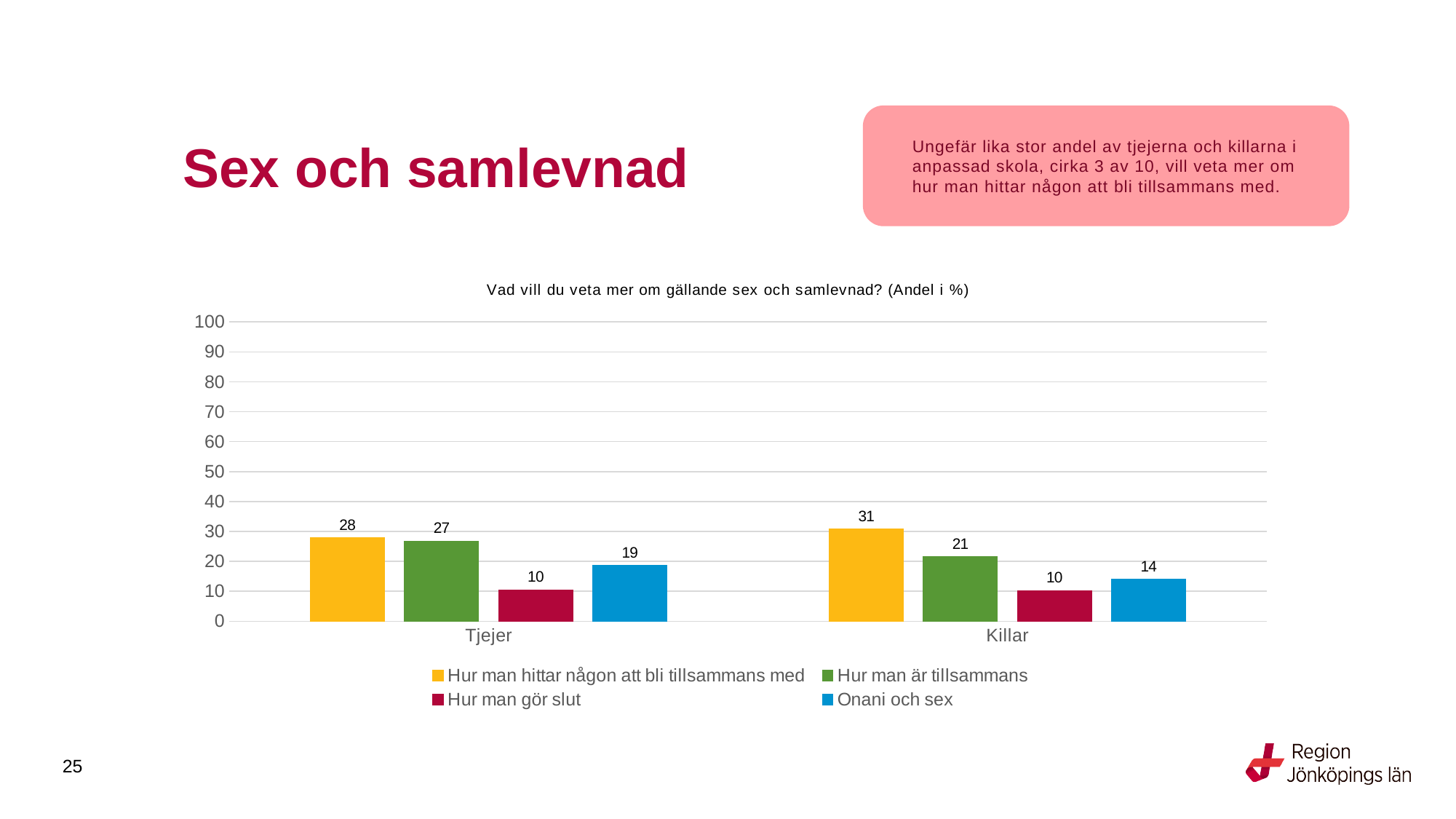
What is the value for "Hur man hittar någon att bli tillsammans med" for Tjejer? 28 Is the value for "Hur man hittar någon att bli tillsammans med" for Killar greater or less than 40? less How many series does the legend list? 4 Which is larger: "Hur man är tillsammans" for Tjejer or for Killar? Tjejer How many categories are shown on the x axis? 2 Which series has the lowest value for Tjejer? Hur man gör slut What is the difference between the "Onani och sex" values for Tjejer and Killar? 5 What is the title of the chart? Vad vill du veta mer om gällande sex och samlevnad? (Andel i %) Which series has the highest value for Killar? Hur man hittar någon att bli tillsammans med What is the value for "Onani och sex" for Killar? 14 What is the value for "Hur man är tillsammans" for Killar? 21 What kind of chart is shown on the slide? Bar chart